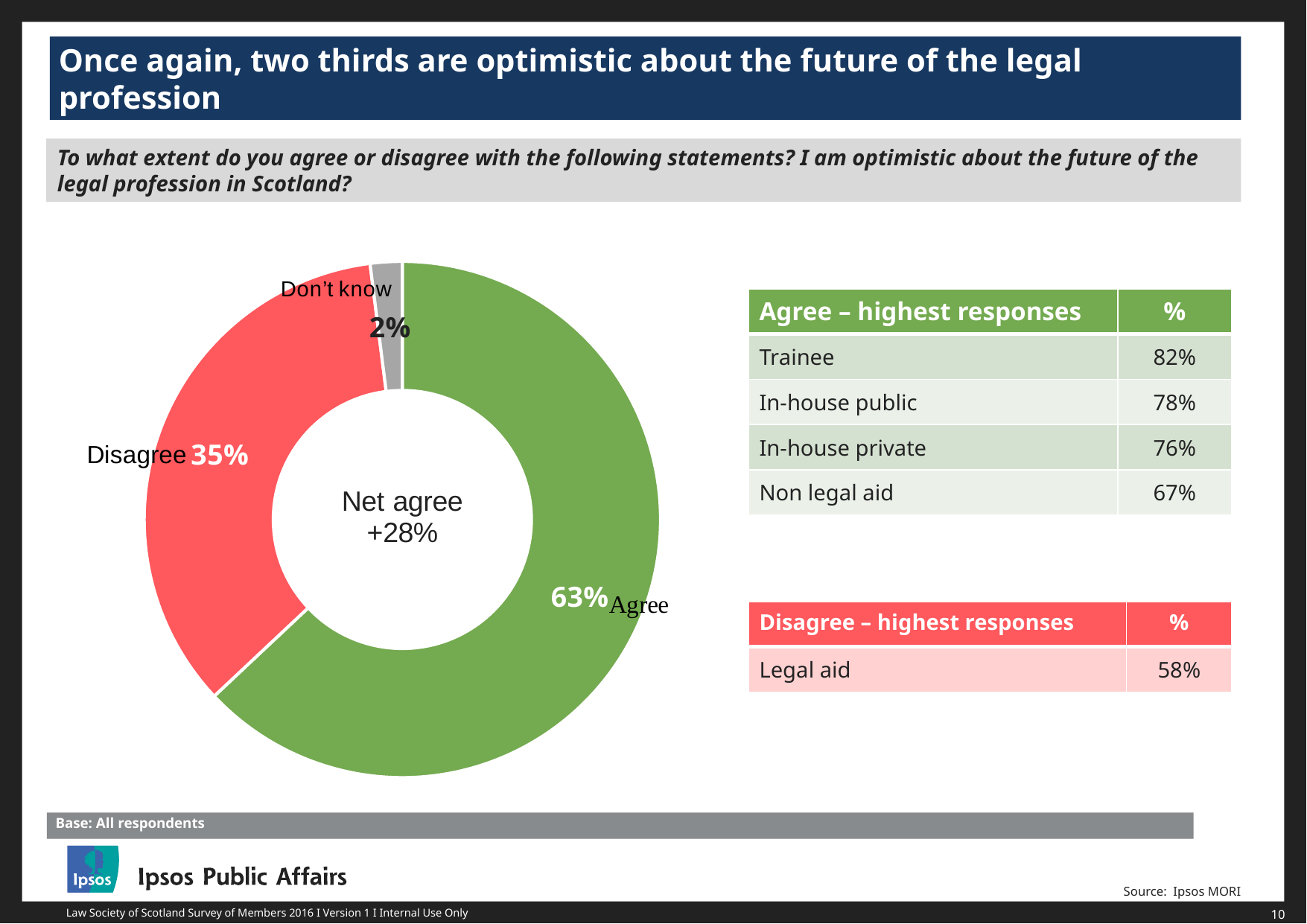
Which response has the largest share of the chart? Agree What percentage of respondents agree that they are optimistic about the future of the legal profession in Scotland? 63% What percentage of respondents disagree? 35% Which is larger, the Disagree share or the Don't know share? Disagree What kind of chart is used to show the responses? Doughnut (pie) chart What colour is the Agree segment of the chart? Green What percentage of respondents answered 'Don't know'? 2% How many response categories are shown in the chart? 3 What is the combined share of Agree and Disagree? 98% What net agree figure is shown in the centre of the chart? +28% What is the difference in percentage points between Agree and Disagree? 28 Which response has the smallest share of the chart? Don't know